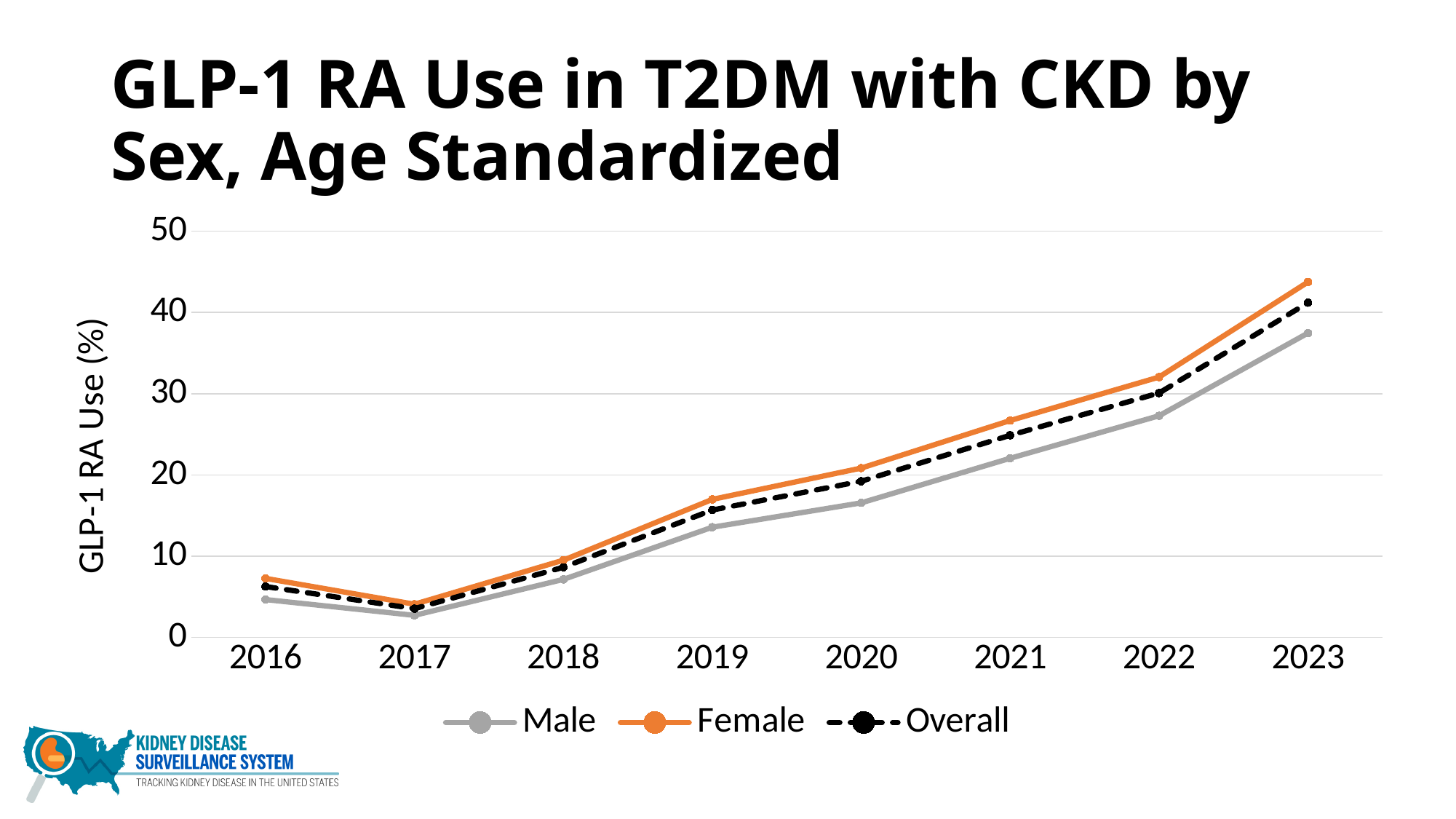
Which series is drawn with a dashed line? Overall How many years are plotted along the x axis? 8 In which year is the Female series at its highest? 2023 In 2023, which series is higher, Male or Female? Female Is the value for Male in 2023 greater or less than 40? less What kind of chart is shown on the slide? line chart Does the Overall series rise or fall from 2017 to 2023? rise Is the value for Male in 2020 greater or less than 20? less In which year is the Male series at its lowest? 2017 What is the label on the y axis? GLP-1 RA Use (%) How many series does the legend list? 3 Is the value for Female in 2023 greater or less than 40? greater